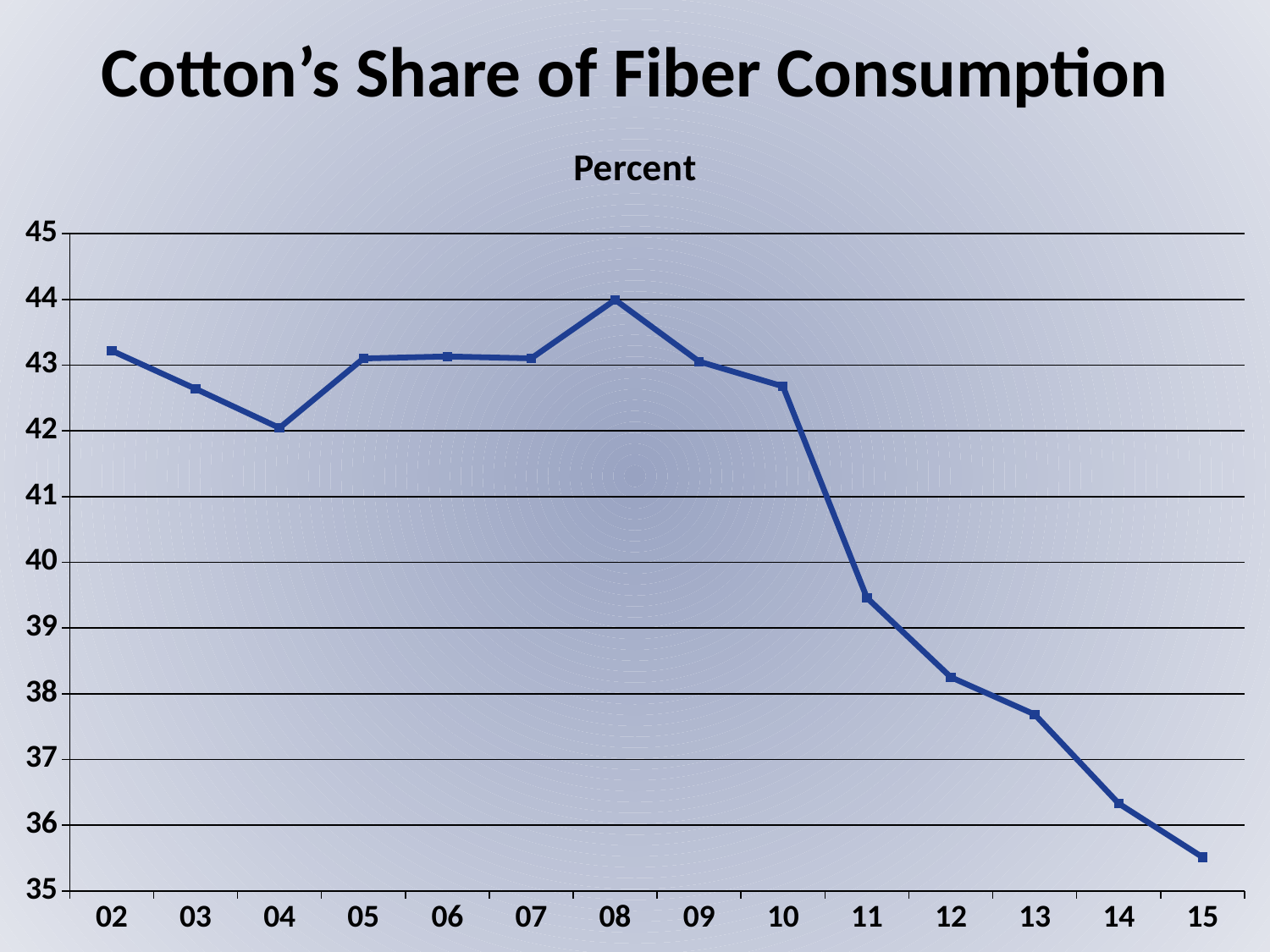
Is the value for 11 greater or less than 40? less Is the value for 14 greater or less than 36? greater Which is larger, the value for 02 or the value for 15? 02 What kind of chart is shown on the slide? line chart Which year has the lowest cotton share of fiber consumption? 15 Is the value for 10 greater or less than 43? less How many data points are plotted on the line? 14 Do the values rise or fall from 10 to 15? fall Which year has the highest cotton share of fiber consumption? 08 What is the title of the chart? Percent